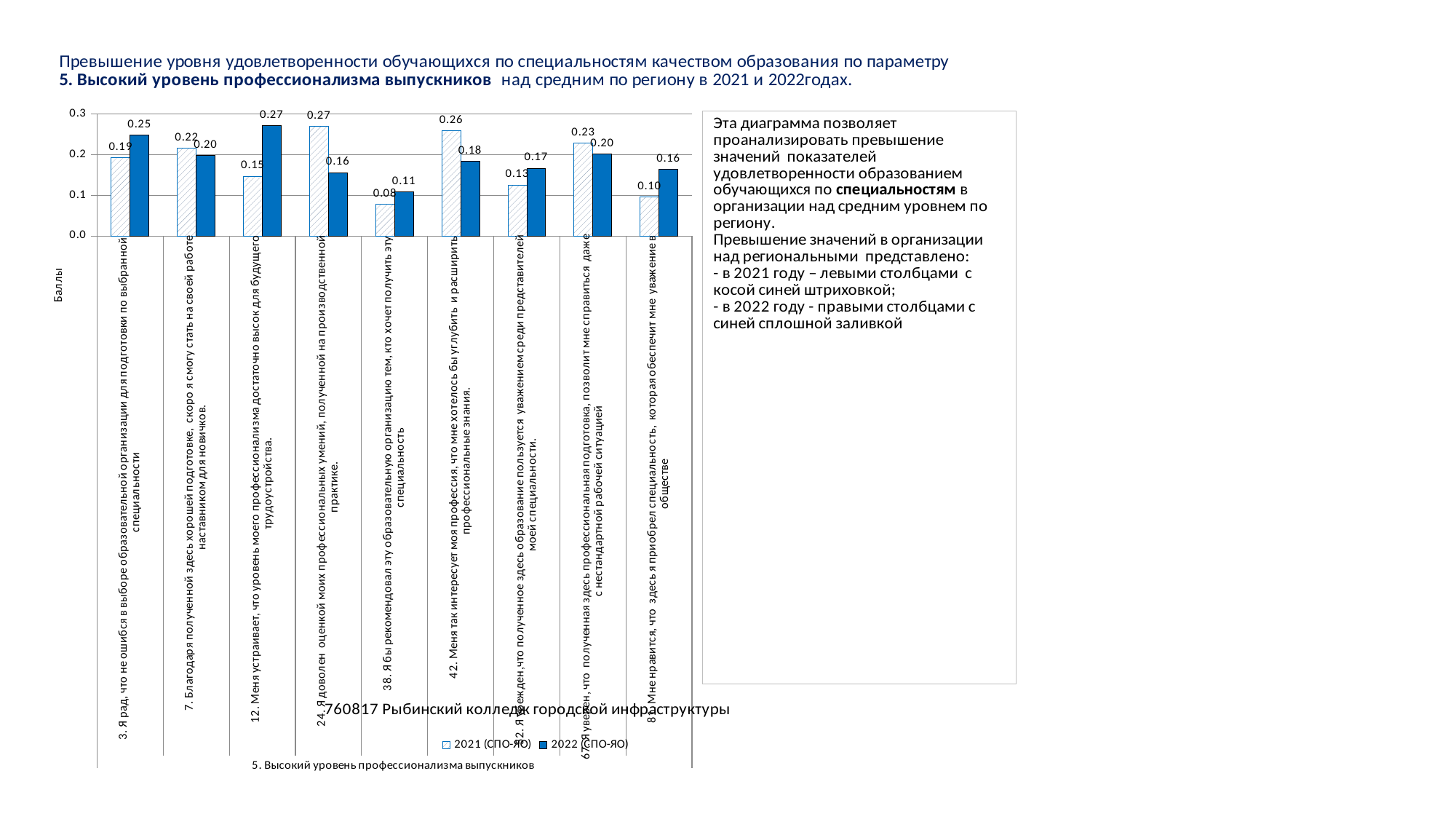
Which item has the lowest 2022 (СПО-ЯО) value? 38. Я бы рекомендовал эту образовательную организацию тем, кто хочет получить эту специальность What is the 2021 (СПО-ЯО) value for item 38 ("Я бы рекомендовал эту образовательную организацию...")? 0.08 What is the difference between the 2022 and 2021 values for item 12 ("Меня устраивает, что уровень моего профессионализма...")? 0.12 How many categories (items) are shown on the x axis of the chart? 9 Which item has the highest 2021 (СПО-ЯО) value? 24. Я доволен оценкой моих профессиональных умений, полученной на производственной практике What is the 2021 (СПО-ЯО) value for item 3 ("Я рад, что не ошибся в выборе образовательной организации...")? 0.19 For item 24 ("Я доволен оценкой моих профессиональных умений..."), which is larger: the 2021 value or the 2022 value? 2021 (СПО-ЯО) What is the label of the vertical axis of the chart? Баллы What type of chart is shown on the slide? Bar chart How many series does the chart legend list? 2 What is the 2022 (СПО-ЯО) value for item 12 ("Меня устраивает, что уровень моего профессионализма достаточно высок...")? 0.27